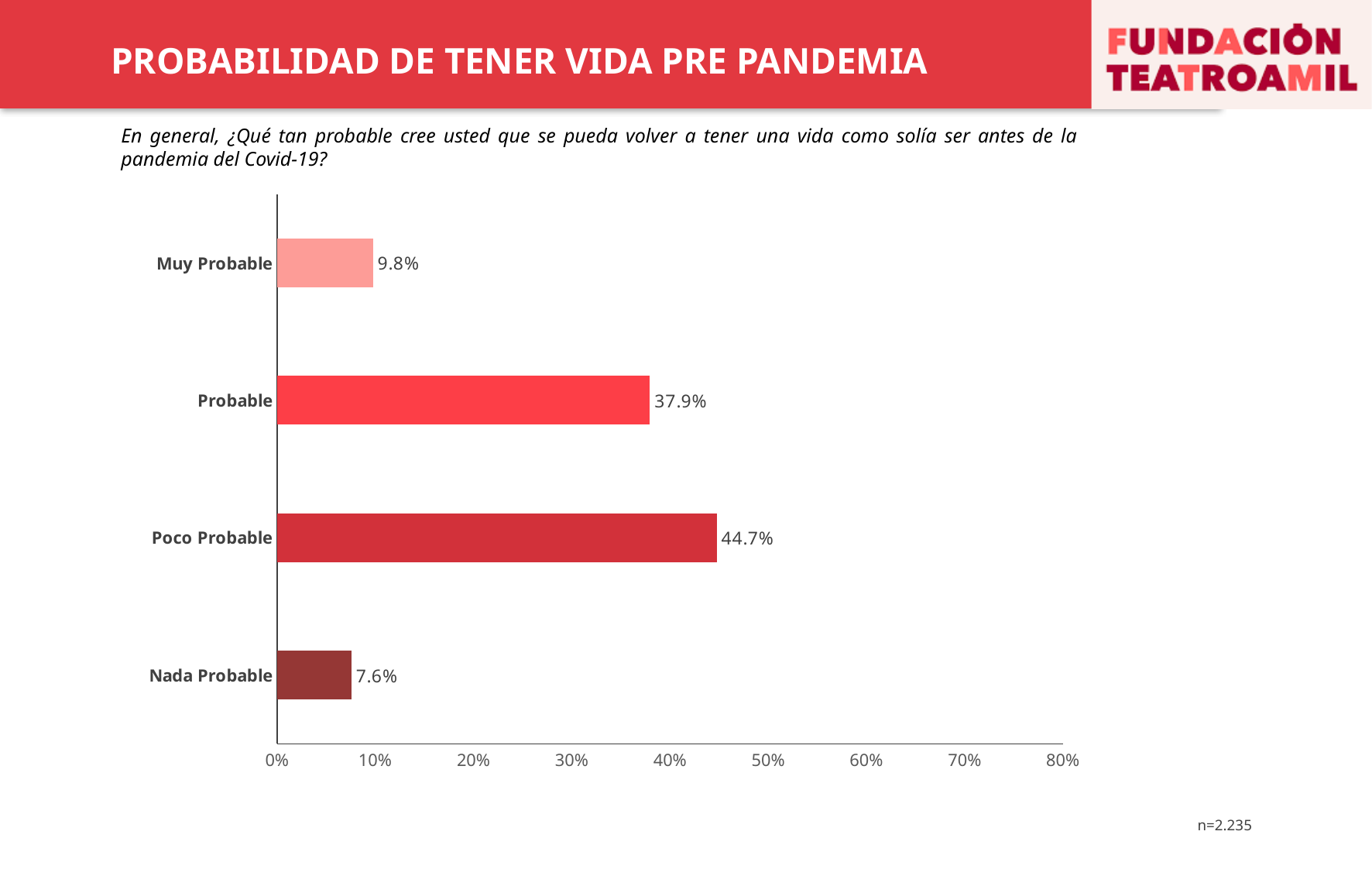
Is the value for Probable greater or less than 30%? greater Which is larger, the value for Muy Probable or the value for Nada Probable? Muy Probable What kind of chart is shown on the slide? bar chart Which category has the highest value? Poco Probable What is the value for Poco Probable? 44.7% What is the difference between the values for Poco Probable and Probable? 6.8% What is the highest value shown on the horizontal axis? 80% What is the value for Probable? 37.9% Which category has the lowest value? Nada Probable What is the value for Muy Probable? 9.8% How many categories are shown in the chart? 4 What is the value for Nada Probable? 7.6%